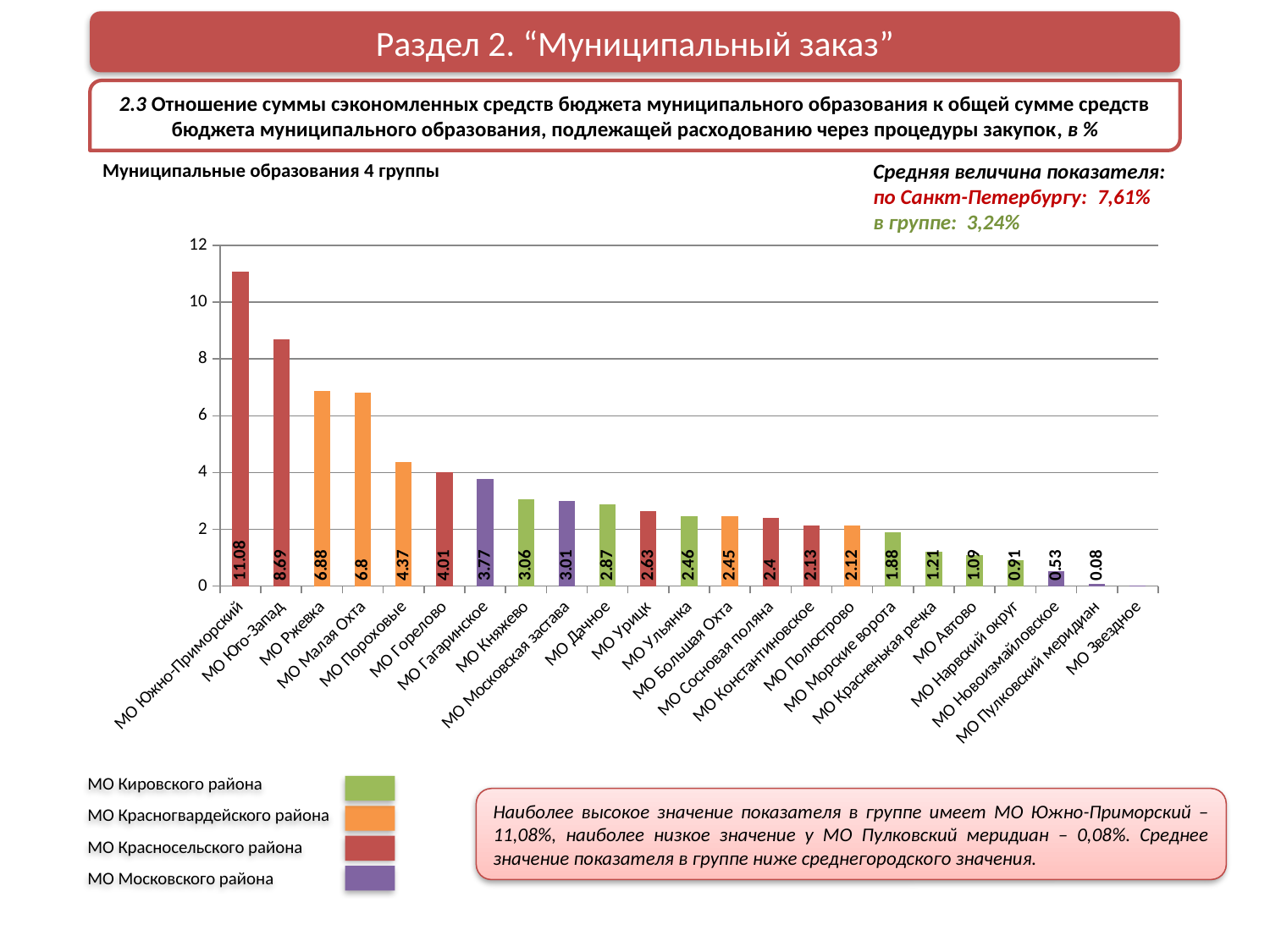
Which labelled municipality has the lowest value on the chart? МО Пулковский меридиан What is the value for МО Южно-Приморский? 11.08 What is the value for МО Морские ворота? 1.88 What is the value for МО Гагаринское? 3.77 Which municipality has the highest value on the chart? МО Южно-Приморский Is the value for МО Горелово greater or less than 4? greater Do the values rise or fall from left to right along the x axis? fall What is the difference between the values for МО Южно-Приморский and МО Юго-Запад? 2.39 What kind of chart is shown on the slide? bar chart How many district groups does the legend list? 4 How many municipalities are shown on the x axis of the chart? 23 Which is larger, the value for МО Ржевка or the value for МО Пороховые? МО Ржевка